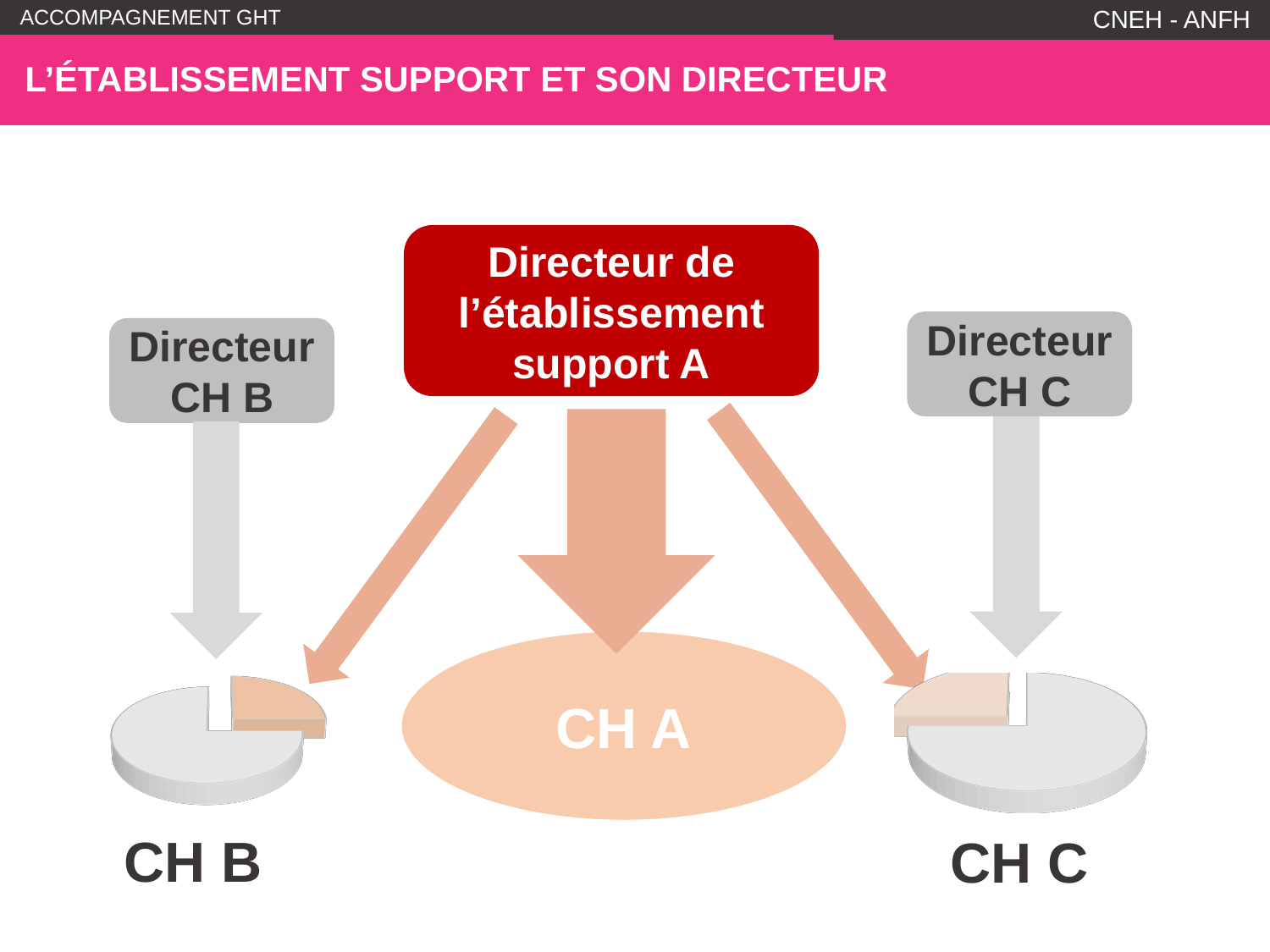
What kind of chart is shown under the label CH C? pie chart In the pie chart labelled CH B, which slice is larger, the grey slice or the orange exploded slice? the grey slice How many slices does the pie chart labelled CH B have? 2 What colour is the exploded (pulled-out) slice in the pie chart labelled CH B? orange In the pie chart labelled CH C, which slice is larger, the grey slice or the orange exploded slice? the grey slice What kind of chart is shown under the label CH B? pie chart What label appears below the pie chart on the left side of the slide? CH B How many slices does the pie chart labelled CH C have? 2 How many pie charts are shown on the slide? 2